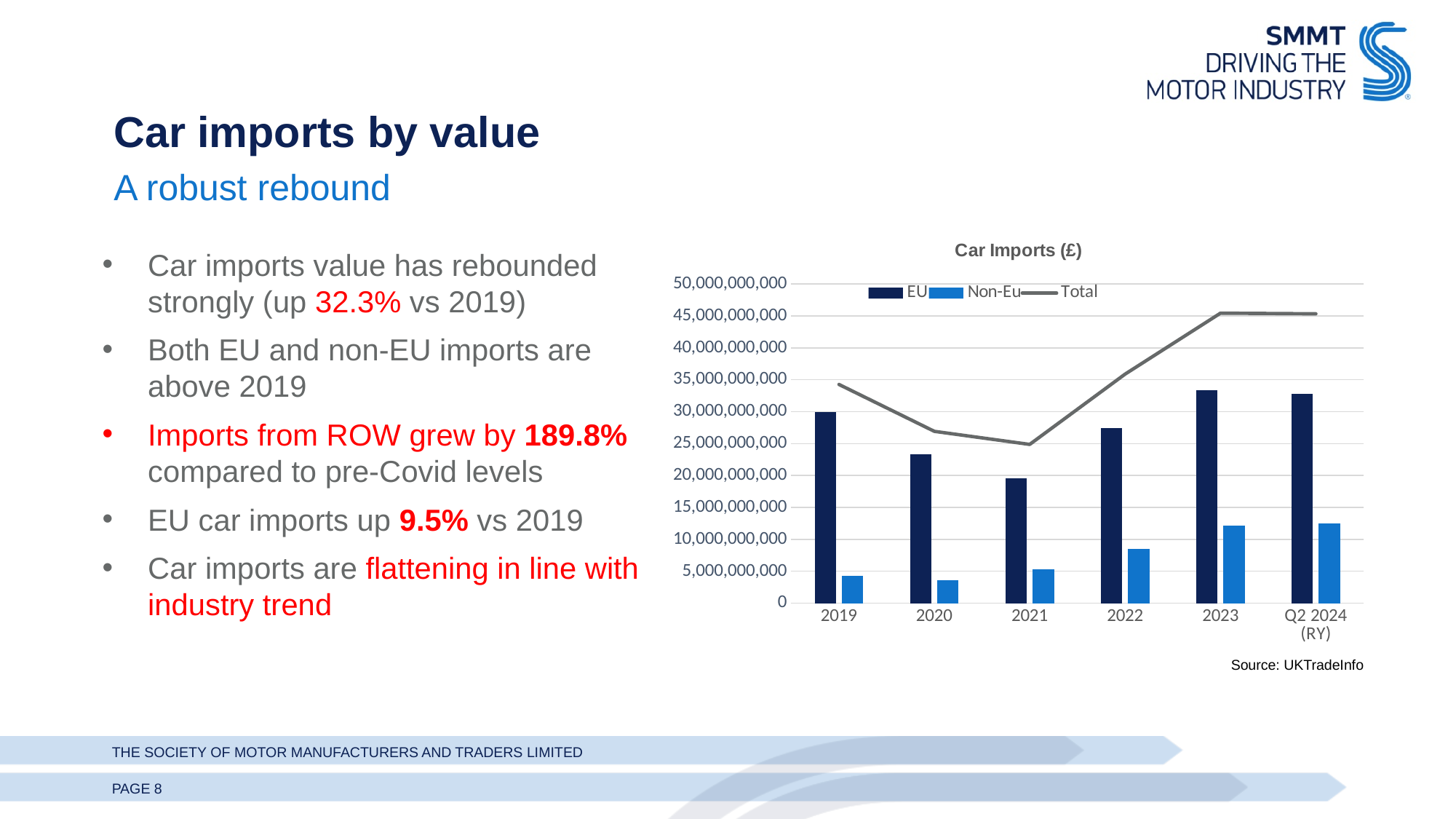
Is the EU value for 2021 greater or less than 20,000,000,000? less What kind of chart is shown on the slide? A bar chart with a line series Is the Total value for 2023 greater or less than 40,000,000,000? greater Which period has the lowest Non-Eu car imports value? 2020 Is the EU value for 2019 greater or less than 25,000,000,000? greater Which is larger, the Non-Eu value for 2021 or the Non-Eu value for 2022? 2022 How many time periods are shown on the x axis of the chart? 6 How many series does the chart legend list? 3 Which period has the lowest EU car imports value? 2021 Which period has the lowest Total car imports value? 2021 Does the Total line rise or fall from 2021 to 2023? rises